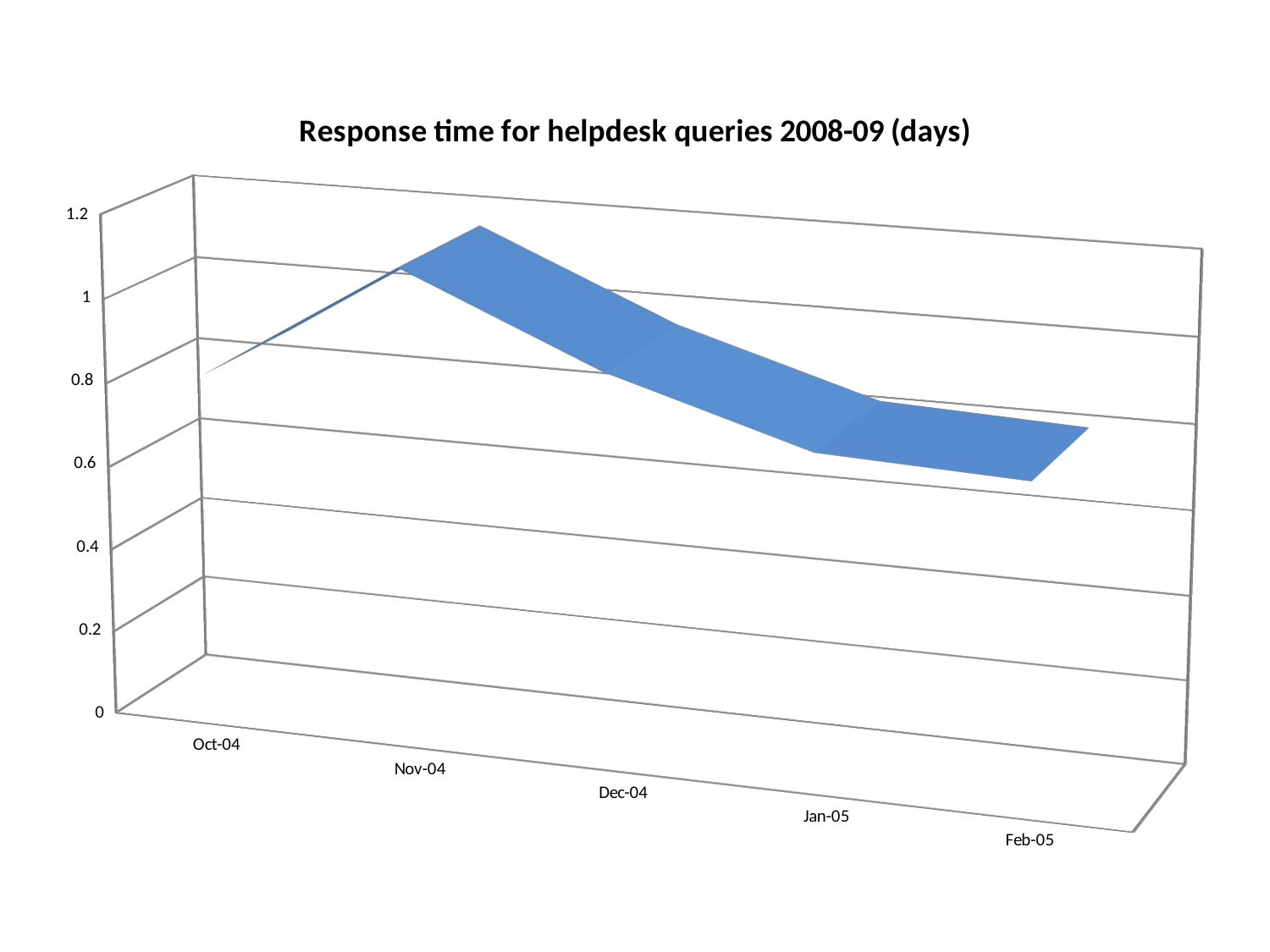
Is the value for Oct-04 greater or less than 0.4? greater Which is higher, the value for Nov-04 or the value for Dec-04? Nov-04 Which month has the highest response time? Nov-04 Is the value for Nov-04 greater or less than 1? greater How many months are plotted along the x axis? 5 Do the values rise or fall from Nov-04 to Feb-05? fall Is the value for Feb-05 greater or less than 1? less Which is higher, the value for Dec-04 or the value for Jan-05? Dec-04 What is the highest value shown on the vertical axis? 1.2 What is the title of the chart? Response time for helpdesk queries 2008-09 (days) What kind of chart is shown on the slide? line chart